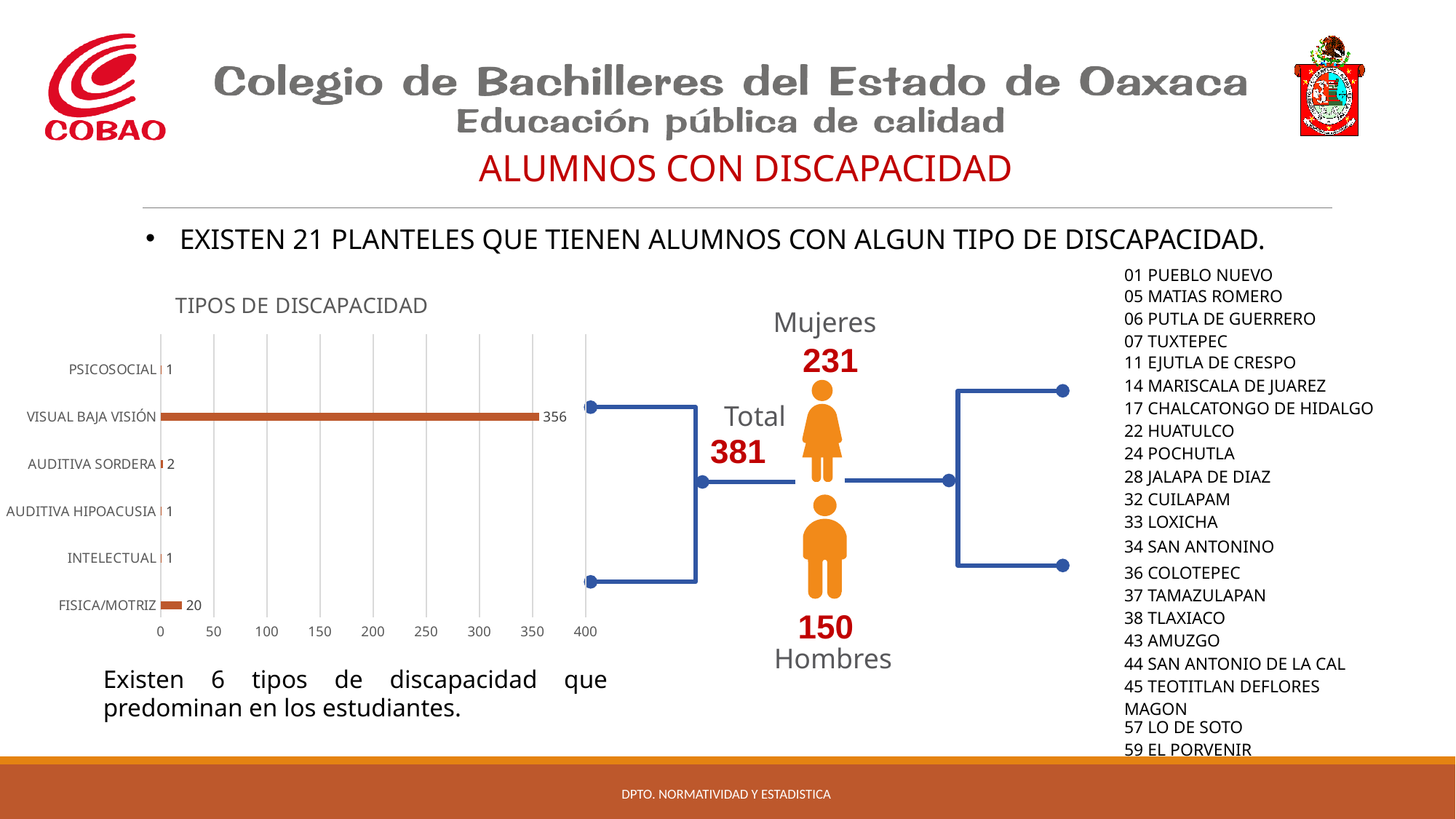
What kind of chart is the TIPOS DE DISCAPACIDAD chart? bar chart What is the difference between the values for FISICA/MOTRIZ and AUDITIVA SORDERA in the TIPOS DE DISCAPACIDAD chart? 18 What is the value for VISUAL BAJA VISIÓN in the TIPOS DE DISCAPACIDAD chart? 356 What is the title of the chart on the slide? TIPOS DE DISCAPACIDAD What is the difference between the values for VISUAL BAJA VISIÓN and FISICA/MOTRIZ in the TIPOS DE DISCAPACIDAD chart? 336 What is the value for PSICOSOCIAL in the TIPOS DE DISCAPACIDAD chart? 1 Is the value for VISUAL BAJA VISIÓN in the TIPOS DE DISCAPACIDAD chart greater or less than 300? greater What is the value for FISICA/MOTRIZ in the TIPOS DE DISCAPACIDAD chart? 20 Which category has the highest value in the TIPOS DE DISCAPACIDAD chart? VISUAL BAJA VISIÓN What is the value for AUDITIVA SORDERA in the TIPOS DE DISCAPACIDAD chart? 2 Which is larger in the TIPOS DE DISCAPACIDAD chart, FISICA/MOTRIZ or AUDITIVA SORDERA? FISICA/MOTRIZ How many categories are shown in the TIPOS DE DISCAPACIDAD chart? 6